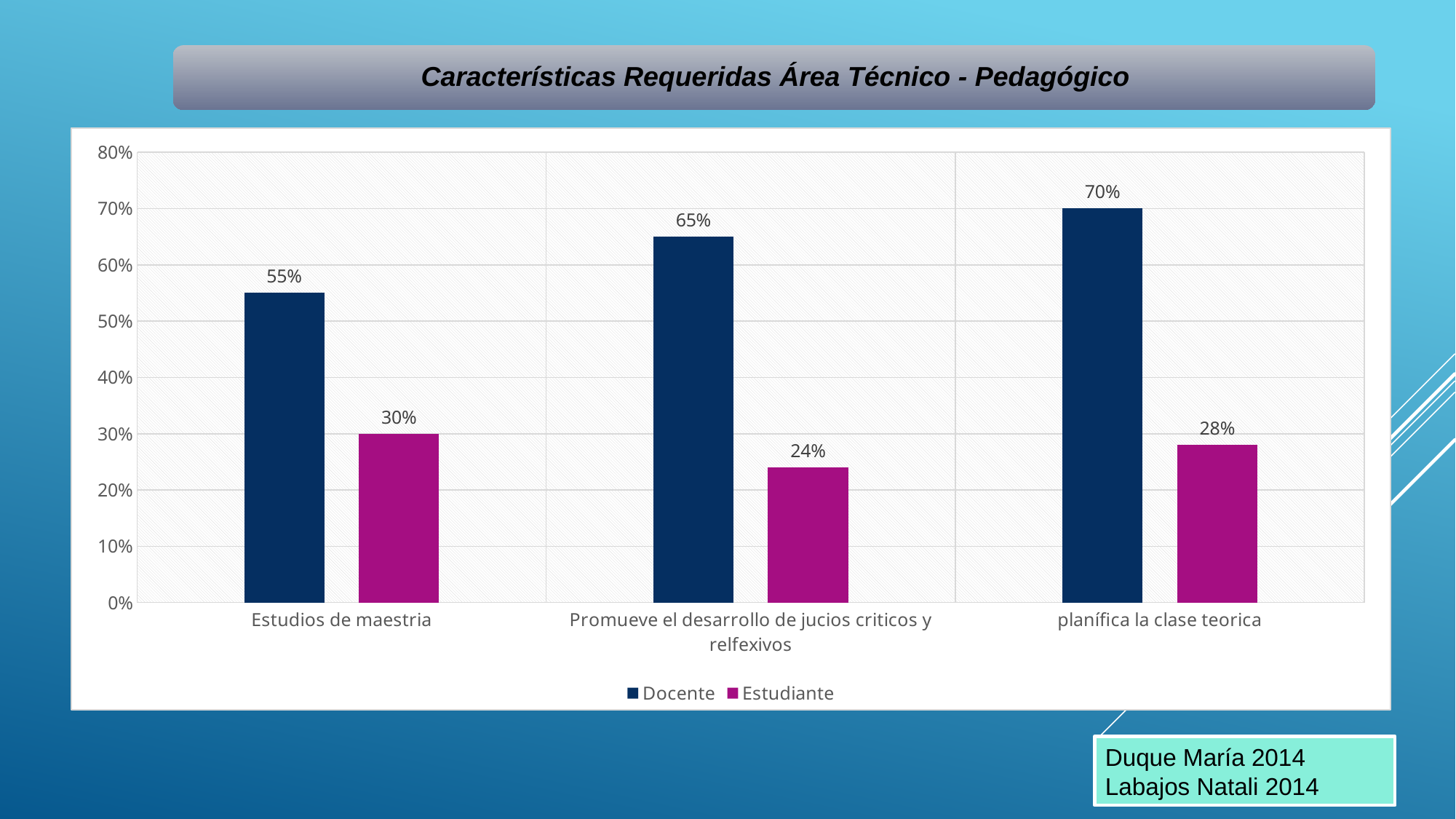
What is the Docente value for planífica la clase teorica? 70% How many categories are shown on the x axis? 3 What is the Estudiante value for Promueve el desarrollo de jucios criticos y relfexivos? 24% What is the Docente value for Estudios de maestria? 55% Is the Estudiante value for planífica la clase teorica greater or less than 30%? less Which category has the lowest Estudiante value? Promueve el desarrollo de jucios criticos y relfexivos What kind of chart is shown on the slide? bar chart Which is larger for planífica la clase teorica, the Docente value or the Estudiante value? Docente What is the title of the slide above the chart? Características Requeridas Área Técnico - Pedagógico What is the difference between the Docente and Estudiante values for Estudios de maestria? 25% Which category has the highest Docente value? planífica la clase teorica How many series does the legend list? 2